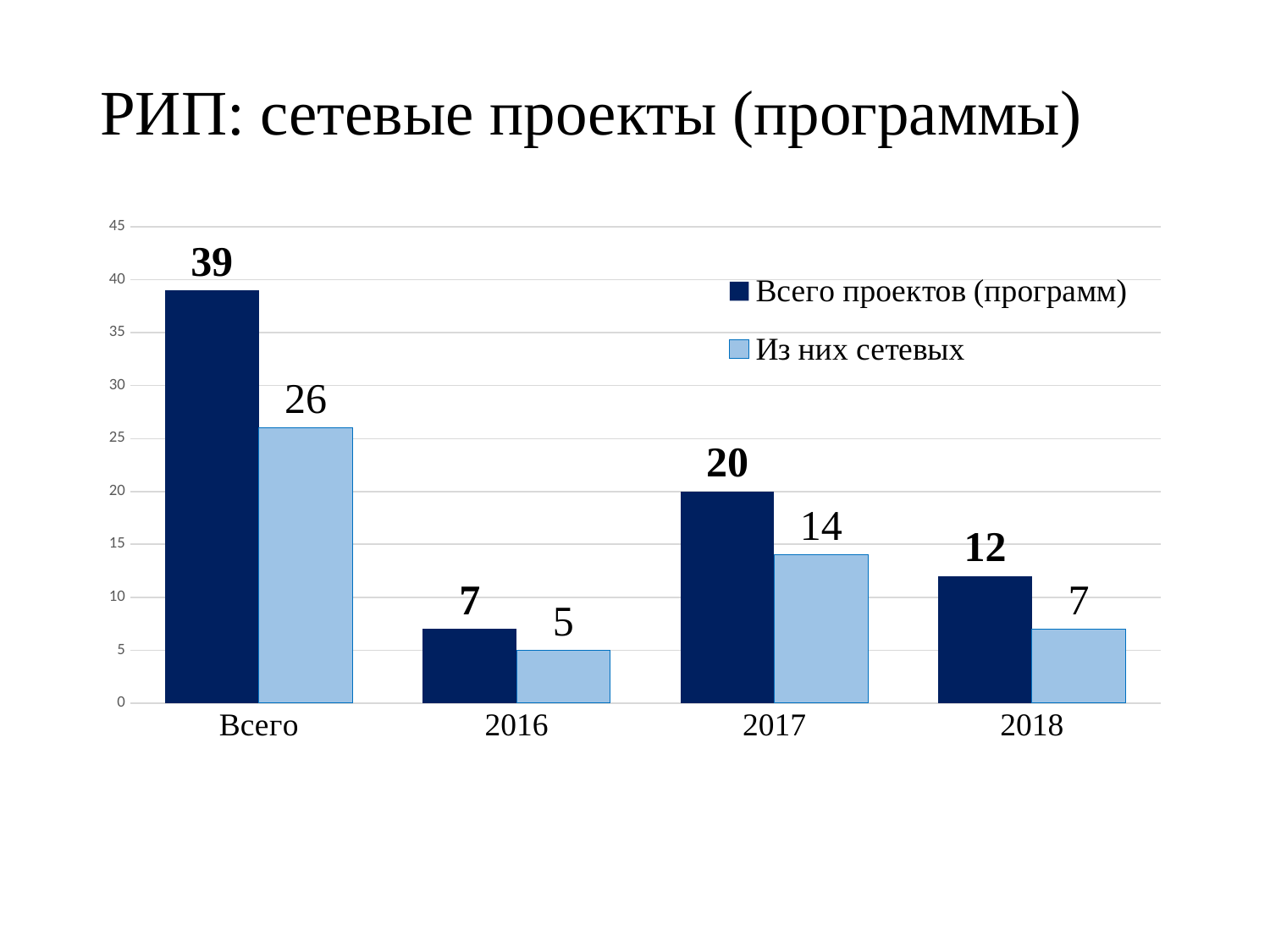
Among the years 2016, 2017 and 2018, which has the lowest value for 'Из них сетевых'? 2016 How many series does the legend list? 2 What is the difference between 'Всего проектов (программ)' and 'Из них сетевых' in the 'Всего' category? 13 What is the value of 'Всего проектов (программ)' for 2018? 12 What is the value of 'Всего проектов (программ)' for 2017? 20 How many categories are shown on the x axis? 4 Among the years 2016, 2017 and 2018, which has the highest value for 'Всего проектов (программ)'? 2017 What is the difference between 'Всего проектов (программ)' and 'Из них сетевых' for 2017? 6 What is the value of 'Из них сетевых' for 2016? 5 What kind of chart is shown on the slide? Bar chart Which is larger: 'Из них сетевых' for 2017 or 'Всего проектов (программ)' for 2018? Из них сетевых for 2017 What is the value of 'Из них сетевых' for the 'Всего' category? 26